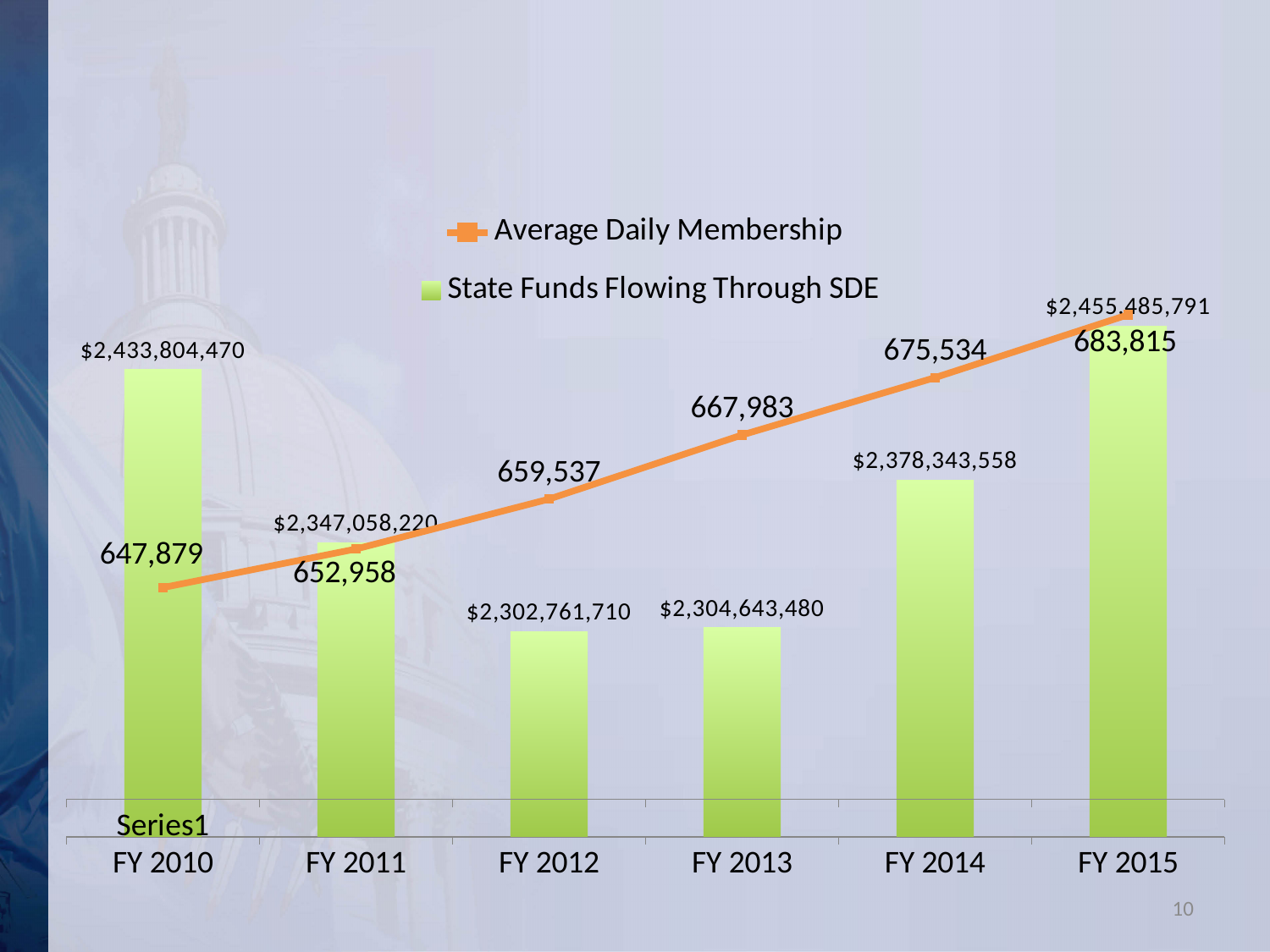
Which fiscal year has the lowest Average Daily Membership? FY 2010 Which is larger, State Funds Flowing Through SDE in FY 2011 or in FY 2014? FY 2014 Which fiscal year has the highest State Funds Flowing Through SDE? FY 2015 By how much did Average Daily Membership increase from FY 2010 to FY 2015? 35,936 What is the Average Daily Membership for FY 2013? 667,983 Which fiscal year has the lowest State Funds Flowing Through SDE? FY 2012 How many series does the legend list? 2 What is the value of State Funds Flowing Through SDE for FY 2014? $2,378,343,558 What is the value of State Funds Flowing Through SDE for FY 2010? $2,433,804,470 How many fiscal years are shown on the x axis? 6 What is the difference in State Funds Flowing Through SDE between FY 2015 and FY 2014? $77,142,233 Does Average Daily Membership rise or fall from FY 2010 to FY 2015? rise